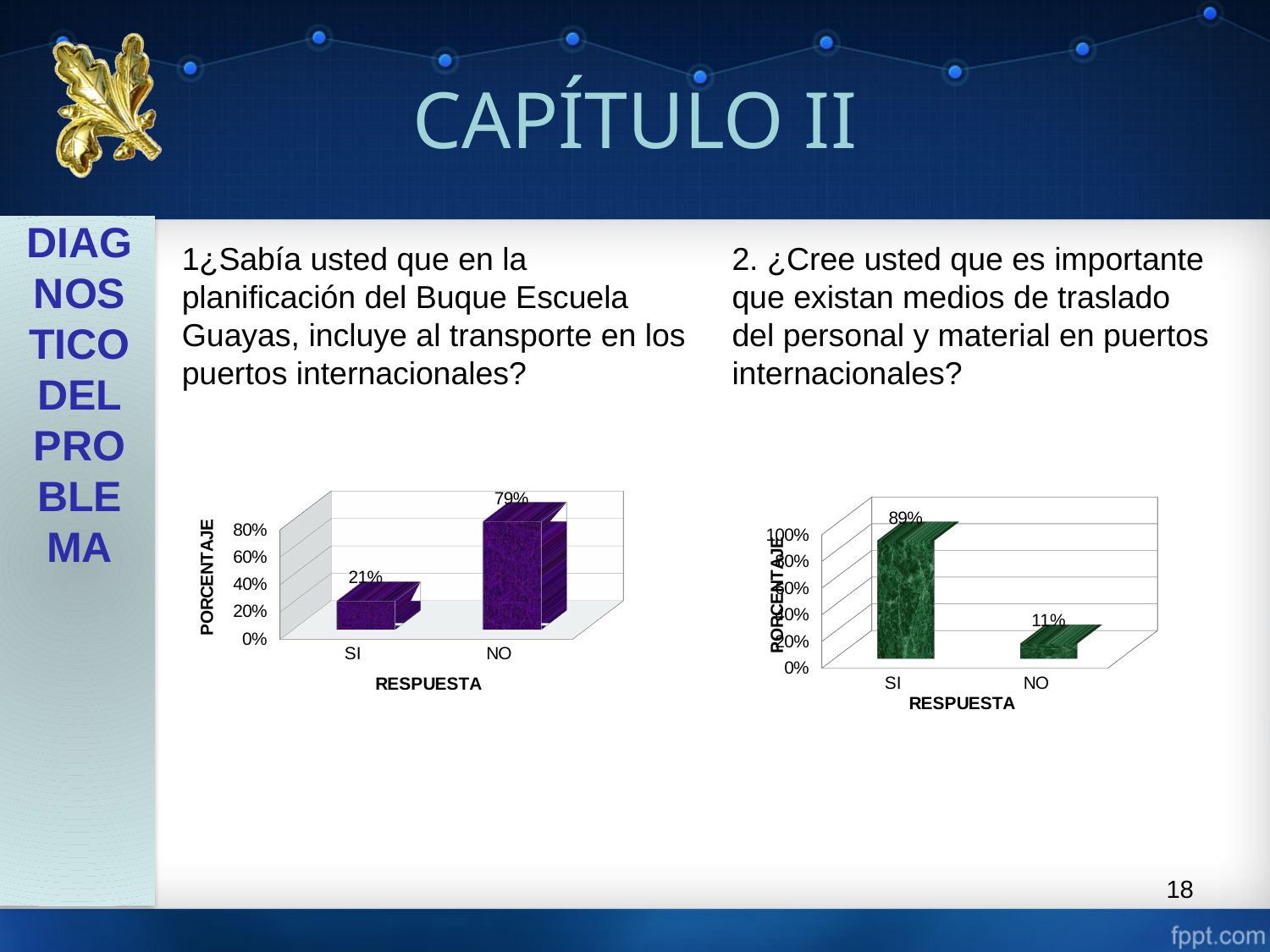
In the right chart (question 2), what is the difference between the SI and NO values? 78% In the left chart (question 1), what is the value for NO? 79% In the right chart (question 2), what is the value for NO? 11% In the right chart (question 2), which response has the lowest value? NO In the right chart (question 2), which is larger, SI or NO? SI What is the x-axis title of the left chart (question 1)? RESPUESTA In the left chart (question 1), what is the value for SI? 21% How many response categories does the left chart (question 1) show? 2 In the right chart (question 2), what is the value for SI? 89% What kind of chart is the right chart (question 2)? Bar chart In the left chart (question 1), which response has the highest value? NO In the left chart (question 1), what is the difference between the NO and SI values? 58%